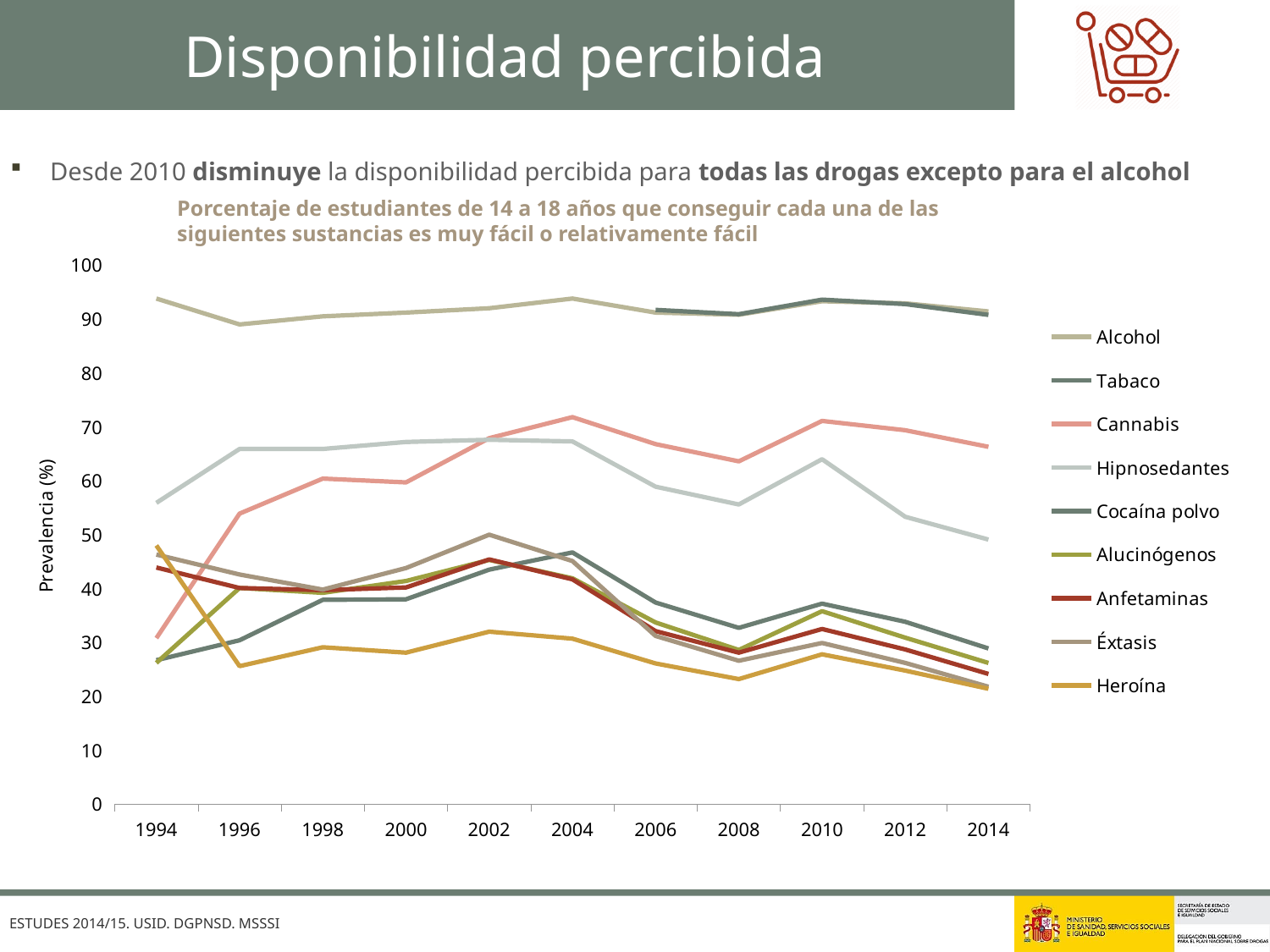
In 1996, which is larger: Alucinógenos or Heroína? Alucinógenos Is the value for Cannabis in 1994 greater or less than 40? less Is the value for Alcohol in 1996 greater or less than 80? greater Which series has the highest value in 1994? Alcohol What is the label on the y axis? Prevalencia (%) How many years are marked along the x axis? 11 In 2014, which is larger: Cannabis or Hipnosedantes? Cannabis Does the Cannabis line rise or fall between 1994 and 2004? rise Is the value for Hipnosedantes in 2010 greater or less than 60? greater Which series has the lowest value in 2008? Heroína What kind of chart is shown on the slide? line chart How many series does the legend list? 9